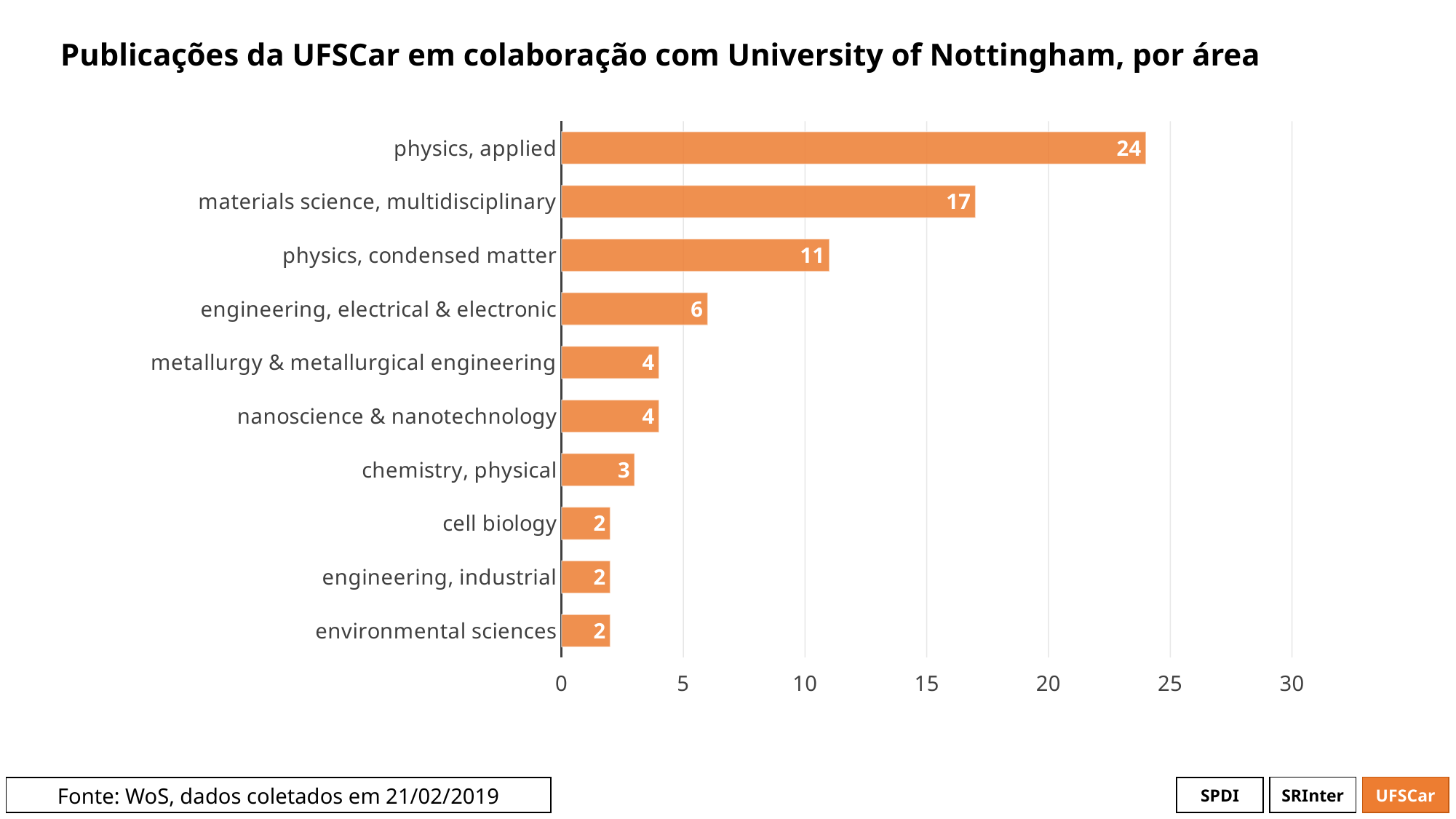
Which area has the highest number of publications? physics, applied What is the value for engineering, electrical & electronic? 6 How many areas are shown in the chart? 10 What is the title of the chart? Publicações da UFSCar em colaboração com University of Nottingham, por área What is the value for materials science, multidisciplinary? 17 Is the value for physics, condensed matter greater or less than 10? greater What is the difference between the values for physics, applied and physics, condensed matter? 13 What is the value for chemistry, physical? 3 Which is larger, the value for materials science, multidisciplinary or the value for engineering, electrical & electronic? materials science, multidisciplinary What is the value for physics, applied? 24 What colour are the bars in the chart? orange What kind of chart is shown on the slide? bar chart